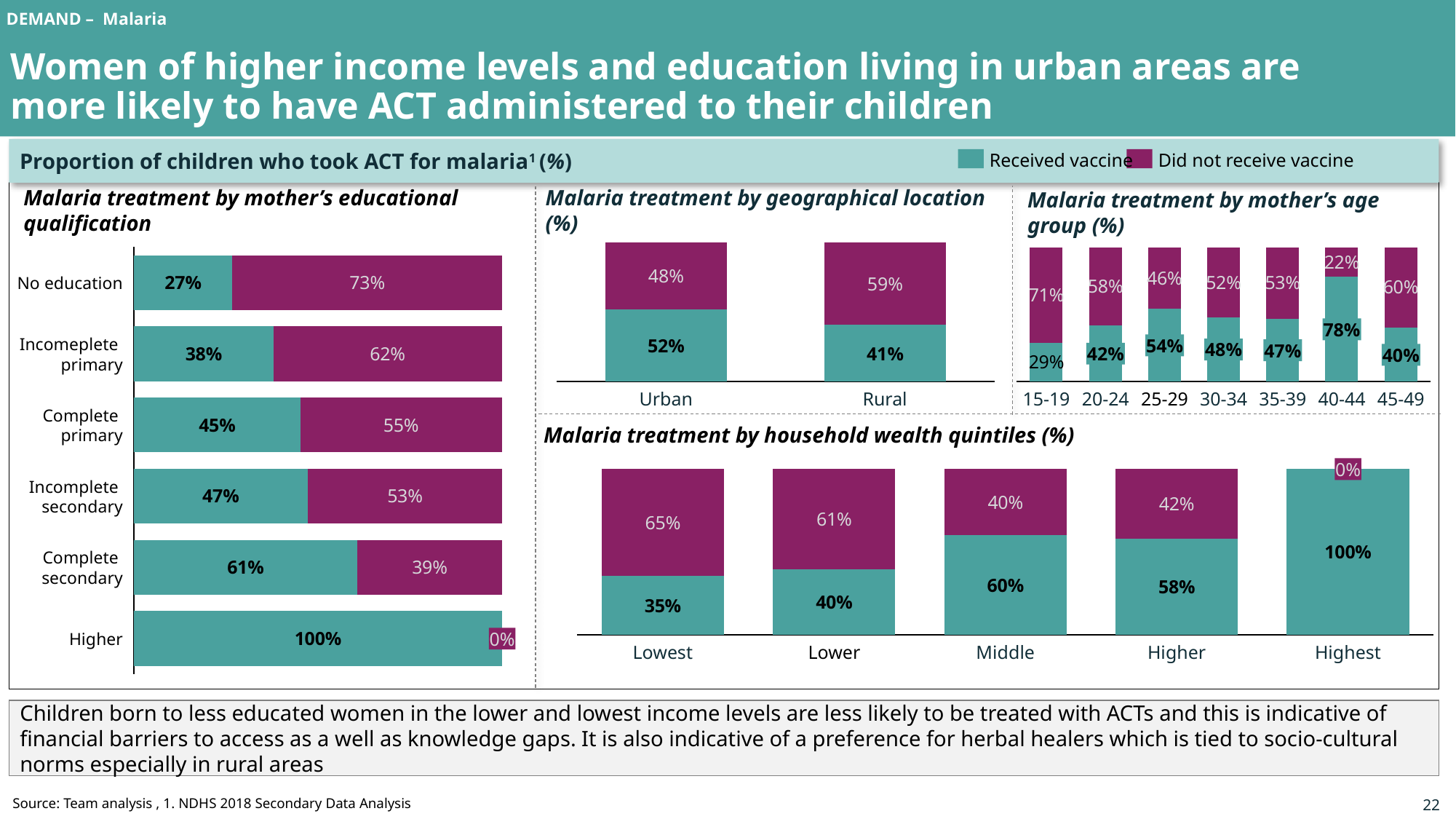
In the chart 'Malaria treatment by mother's educational qualification', what is the difference between the 'Did not receive vaccine' values for 'No education' and 'Complete secondary'? 34% How many age groups are shown in the chart 'Malaria treatment by mother's age group (%)'? 7 In the chart 'Malaria treatment by household wealth quintiles (%)', what is the 'Received vaccine' value for 'Middle'? 60% In the chart 'Malaria treatment by household wealth quintiles (%)', what is the difference between the 'Received vaccine' values for 'Highest' and 'Lowest'? 65% In the chart 'Malaria treatment by mother's age group (%)', which age group has the lowest 'Received vaccine' value? 15-19 How many series does the legend list for the charts on this slide? 2 In the chart 'Malaria treatment by geographical location (%)', what is the 'Did not receive vaccine' value for 'Rural'? 59% In the chart 'Malaria treatment by mother's educational qualification', what is the 'Received vaccine' value for 'No education'? 27% In the chart 'Malaria treatment by geographical location (%)', which has the larger 'Received vaccine' value, Urban or Rural? Urban How many categories are shown in the chart 'Malaria treatment by mother's educational qualification'? 6 In the chart 'Malaria treatment by mother's age group (%)', what is the 'Received vaccine' value for the '40-44' age group? 78% In the chart 'Malaria treatment by mother's educational qualification', which category has the highest 'Received vaccine' value? Higher